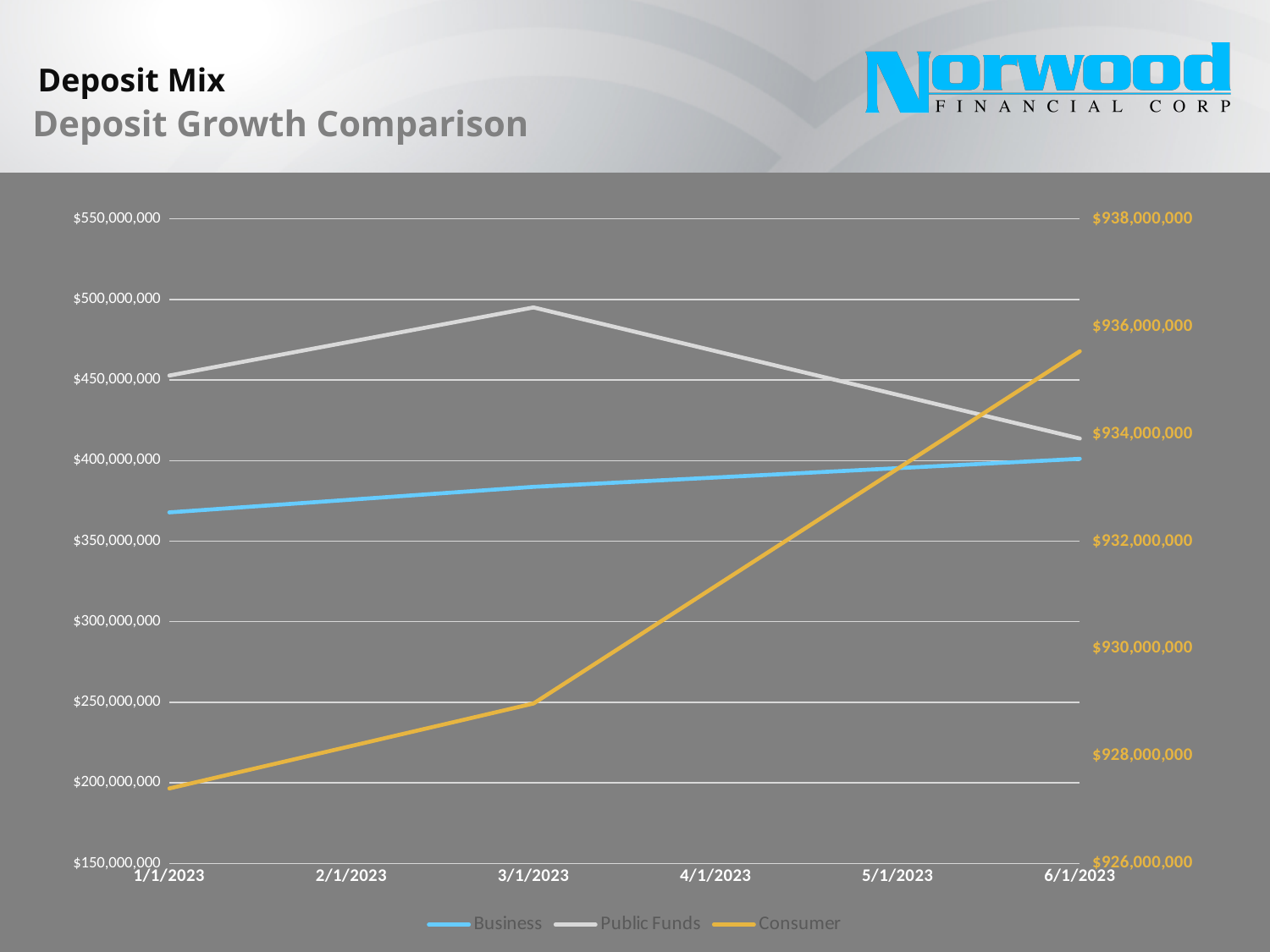
What kind of chart is shown on the slide? Line chart How many dates are plotted along the x axis? 6 Is the value for Public Funds at 3/1/2023 greater or less than $450,000,000? greater Does the Business line rise or fall from 1/1/2023 to 6/1/2023? Rises Is the value for Business at 1/1/2023 greater or less than $400,000,000? less At which date does the Public Funds line reach its lowest value? 6/1/2023 What is the title of the chart? Deposit Growth Comparison Which series are listed in the legend? Business, Public Funds, Consumer Is the value for Public Funds at 6/1/2023 greater or less than $450,000,000? less At which date does the Public Funds line reach its highest value? 3/1/2023 How many series does the legend list? 3 At 3/1/2023, which is larger, Public Funds or Business? Public Funds